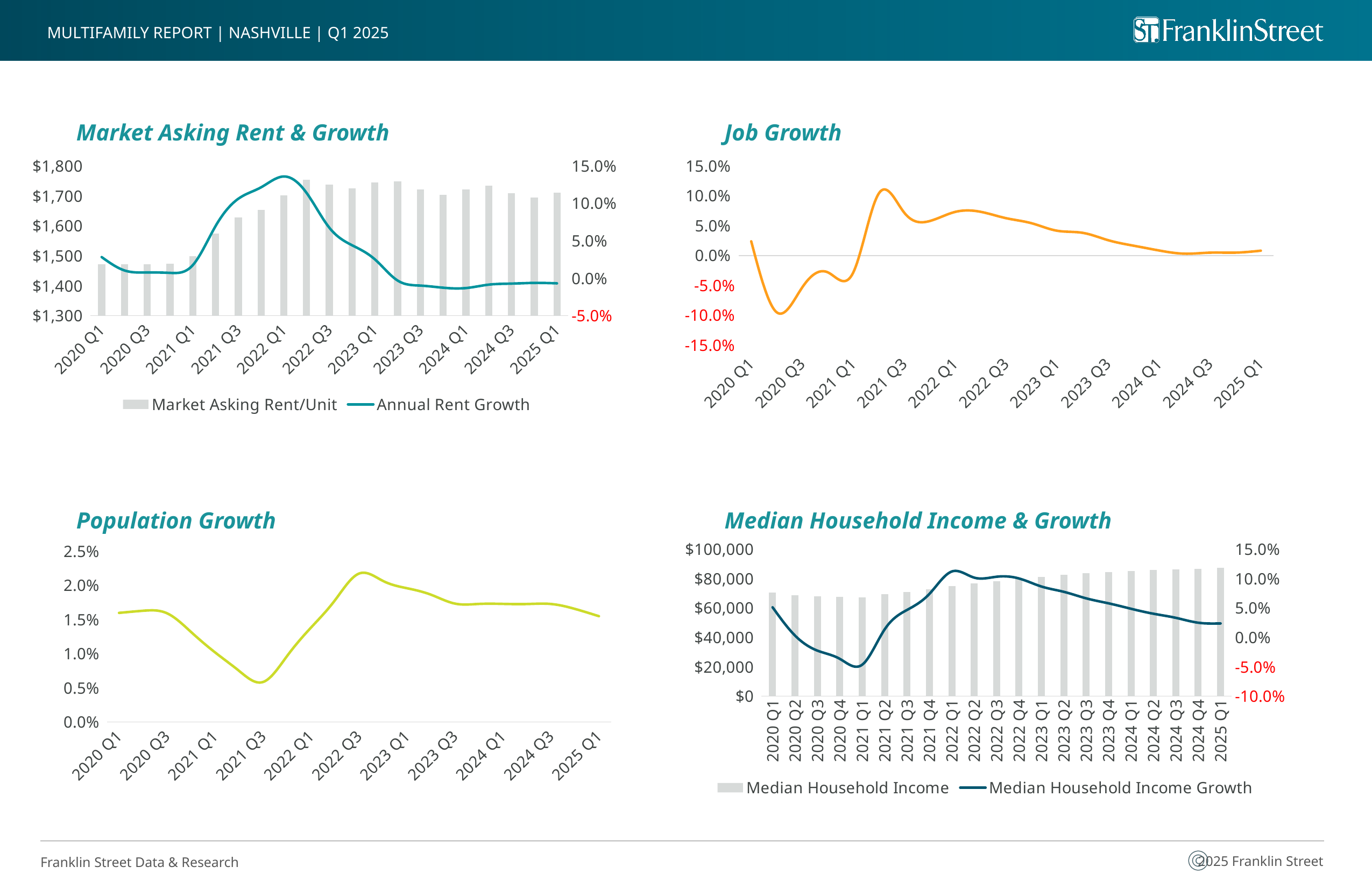
What kind of chart is the Market Asking Rent & Growth chart? Combined bar and line chart In the Market Asking Rent & Growth chart, is the Annual Rent Growth for 2022 Q1 greater or less than 10.0%? greater In the Population Growth chart, is the value for 2022 Q3 greater or less than 2.0%? greater In the Median Household Income & Growth chart, how many quarters are shown on the x axis? 21 What kind of chart is the Job Growth chart? Line chart In the Median Household Income & Growth chart, is the Median Household Income Growth for 2021 Q1 greater or less than 0.0%? less In the Market Asking Rent & Growth chart, how many series does the legend list? 2 In the Median Household Income & Growth chart, do the Median Household Income bars rise or fall from 2022 Q1 to 2025 Q1? rise